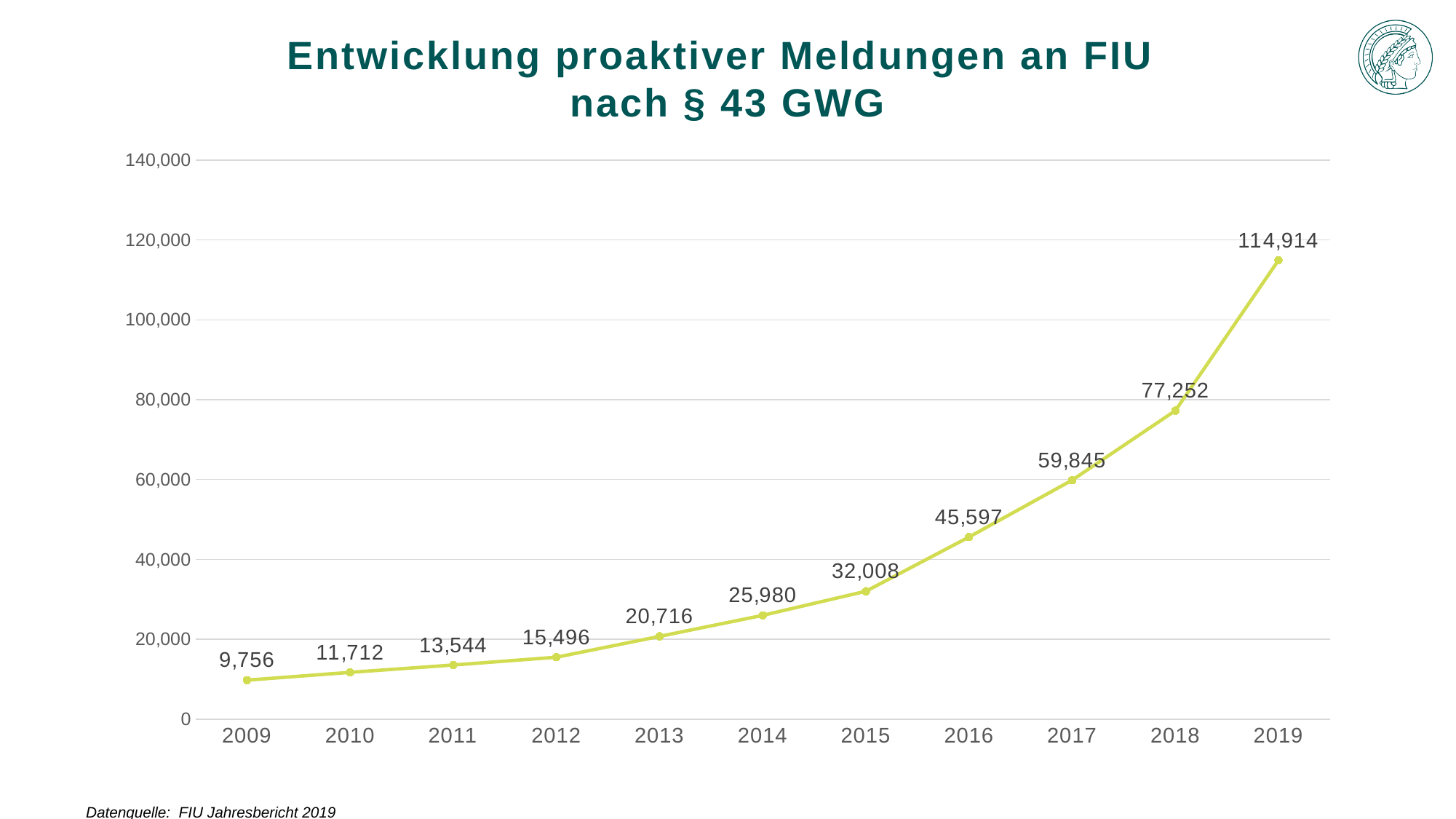
What is the difference between the values for 2010 and 2009? 1,956 What is the value for 2015? 32,008 Is the value for 2018 greater or less than 80,000? less Do the values rise or fall from 2009 to 2019? rise What kind of chart is shown? line chart What is the value for 2009? 9,756 How many years are plotted on the x axis? 11 Which year has the lowest value? 2009 What is the difference between the values for 2019 and 2018? 37,662 Which year has the highest value? 2019 Which is larger, the value for 2016 or the value for 2017? 2017 What is the value for 2019? 114,914